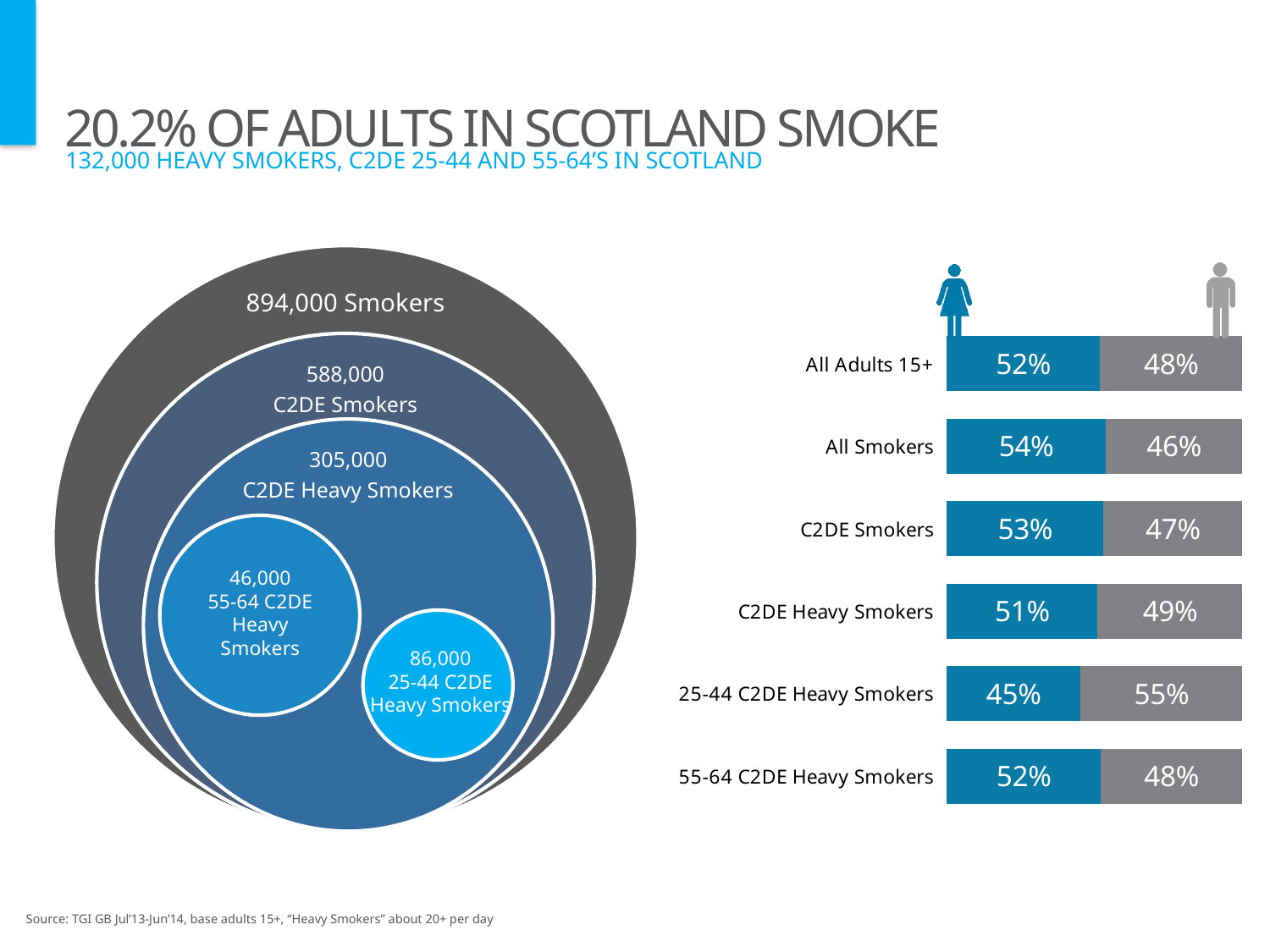
On the bar chart on the right, which category has the lowest female share? 25-44 C2DE Heavy Smokers What kind of chart is shown on the right of the slide? Stacked bar chart On the nested circle diagram on the left, how many C2DE Heavy Smokers are shown? 305,000 How many categories does the bar chart on the right show? 6 On the bar chart on the right, what is the male share for 25-44 C2DE Heavy Smokers? 55% On the bar chart on the right, which category has the highest female share? All Smokers On the bar chart on the right, is the female share larger for C2DE Smokers or for C2DE Heavy Smokers? C2DE Smokers On the bar chart on the right, what is the female share for All Smokers? 54% On the nested circle diagram on the left, how many 25-44 C2DE Heavy Smokers are shown? 86,000 On the bar chart on the right, what is the female share for C2DE Heavy Smokers? 51% On the nested circle diagram on the left, what is the difference between the number of C2DE Smokers and the number of C2DE Heavy Smokers? 283,000 On the bar chart on the right, what is the difference between the female share for All Smokers and the female share for 25-44 C2DE Heavy Smokers? 9%